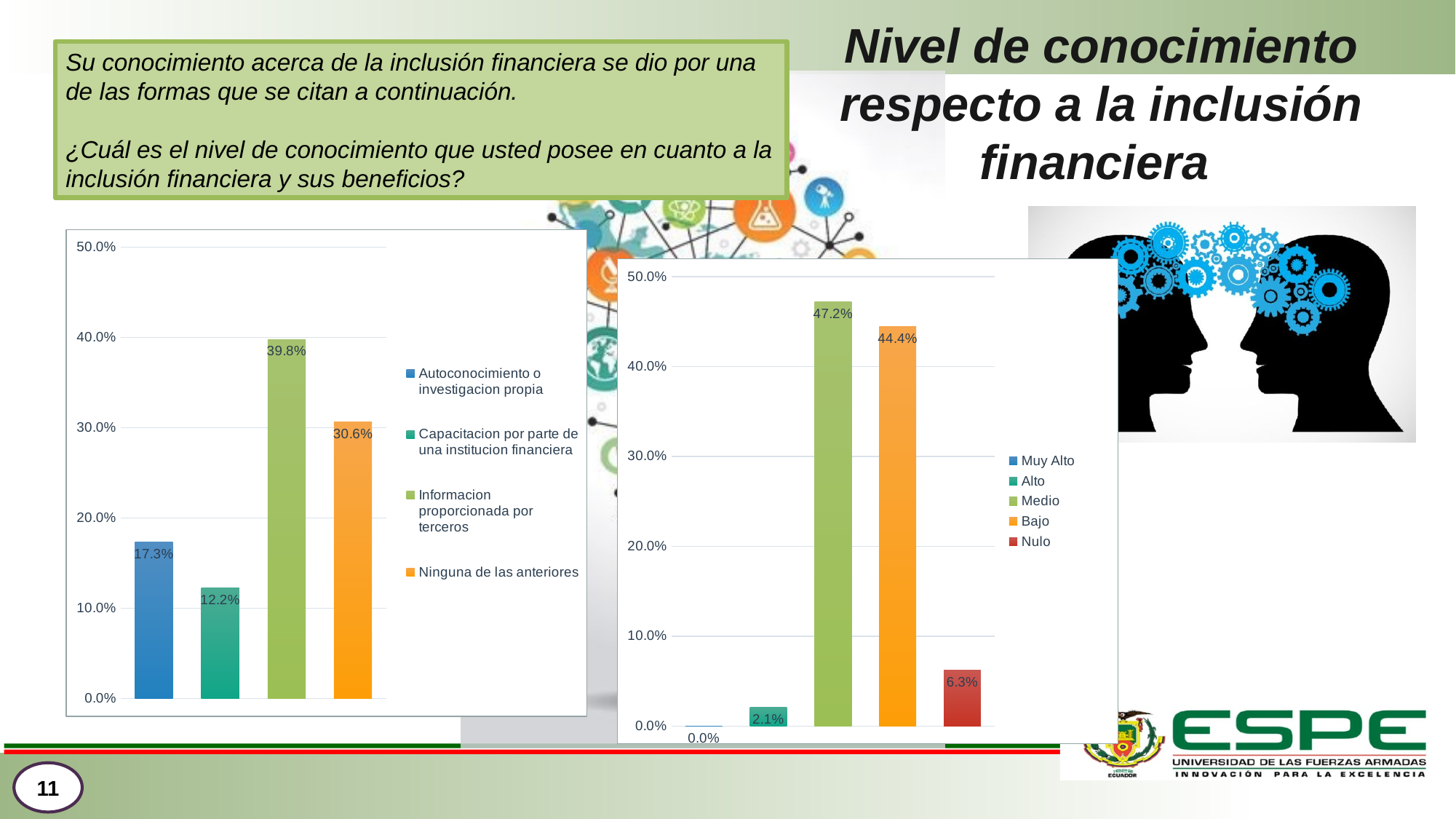
What kind of chart is the right chart? Bar chart In the left chart, what is the value for 'Informacion proporcionada por terceros'? 39.8% In the right chart, which category has the lowest value? Muy Alto In the right chart, which is larger, 'Alto' or 'Nulo'? Nulo In the left chart, what is the difference between 'Informacion proporcionada por terceros' and 'Ninguna de las anteriores'? 9.2% In the left chart, how many series does the legend list? 4 In the right chart, what is the value for 'Medio'? 47.2% In the left chart, what is the value for 'Capacitacion por parte de una institucion financiera'? 12.2% In the right chart, what is the value for 'Nulo'? 6.3% In the right chart, which category has the highest value? Medio In the right chart, what is the difference between 'Medio' and 'Bajo'? 2.8% In the left chart, which category has the lowest value? Capacitacion por parte de una institucion financiera